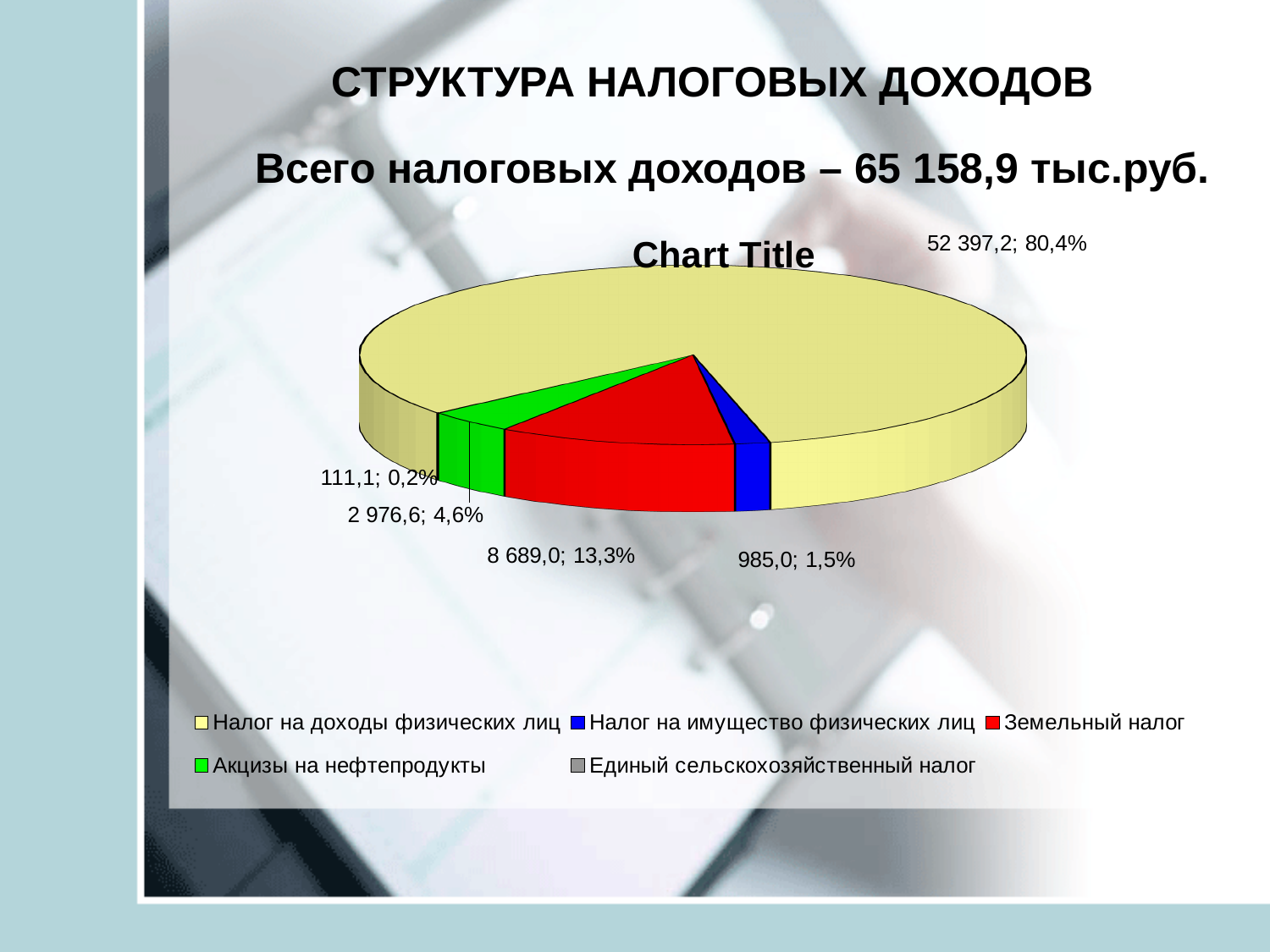
How many categories does the legend list? 5 What share of the pie does Налог на доходы физических лиц represent? 80,4% What is the value shown for Налог на имущество физических лиц? 985,0 What share of the pie does Акцизы на нефтепродукты represent? 4,6% Which is larger, Земельный налог or Акцизы на нефтепродукты? Земельный налог What share of the pie does Земельный налог represent? 13,3% What is the title printed above the pie chart? Chart Title What is the value shown for Земельный налог? 8 689,0 Which category has the smallest slice of the pie? Единый сельскохозяйственный налог Which category has the largest slice of the pie? Налог на доходы физических лиц What type of chart is shown on the slide? pie chart What is the value shown for Налог на доходы физических лиц? 52 397,2